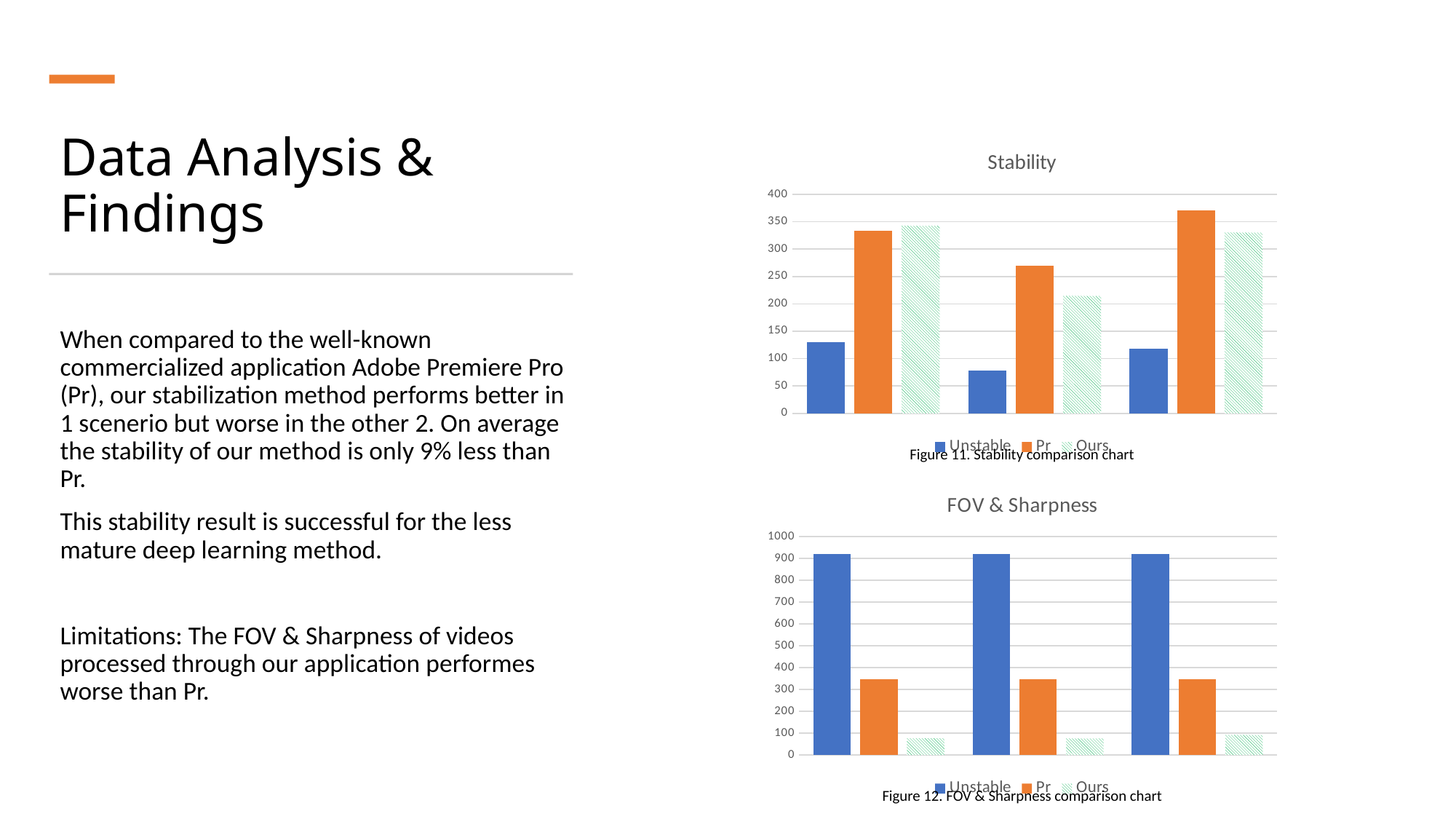
What are the legend entries of the Stability chart? Unstable, Pr, Ours What kind of chart is the Stability chart? bar chart In the FOV & Sharpness chart, is the Unstable value in the first group greater or less than 800? greater In the Stability chart, which series has the tallest bar overall? Pr In the FOV & Sharpness chart, is the Ours value in the third group greater or less than 200? less In the Stability chart, is the Unstable value in the second group greater or less than 100? less In the Stability chart, which series has the shortest bar overall? Unstable How many series does the legend of the FOV & Sharpness chart list? 3 In the Stability chart, in the second group of bars, which is larger: Pr or Ours? Pr How many groups of bars are plotted in the Stability chart? 3 In the FOV & Sharpness chart, do the Unstable values rise, fall, or stay about the same across the three groups? stay about the same